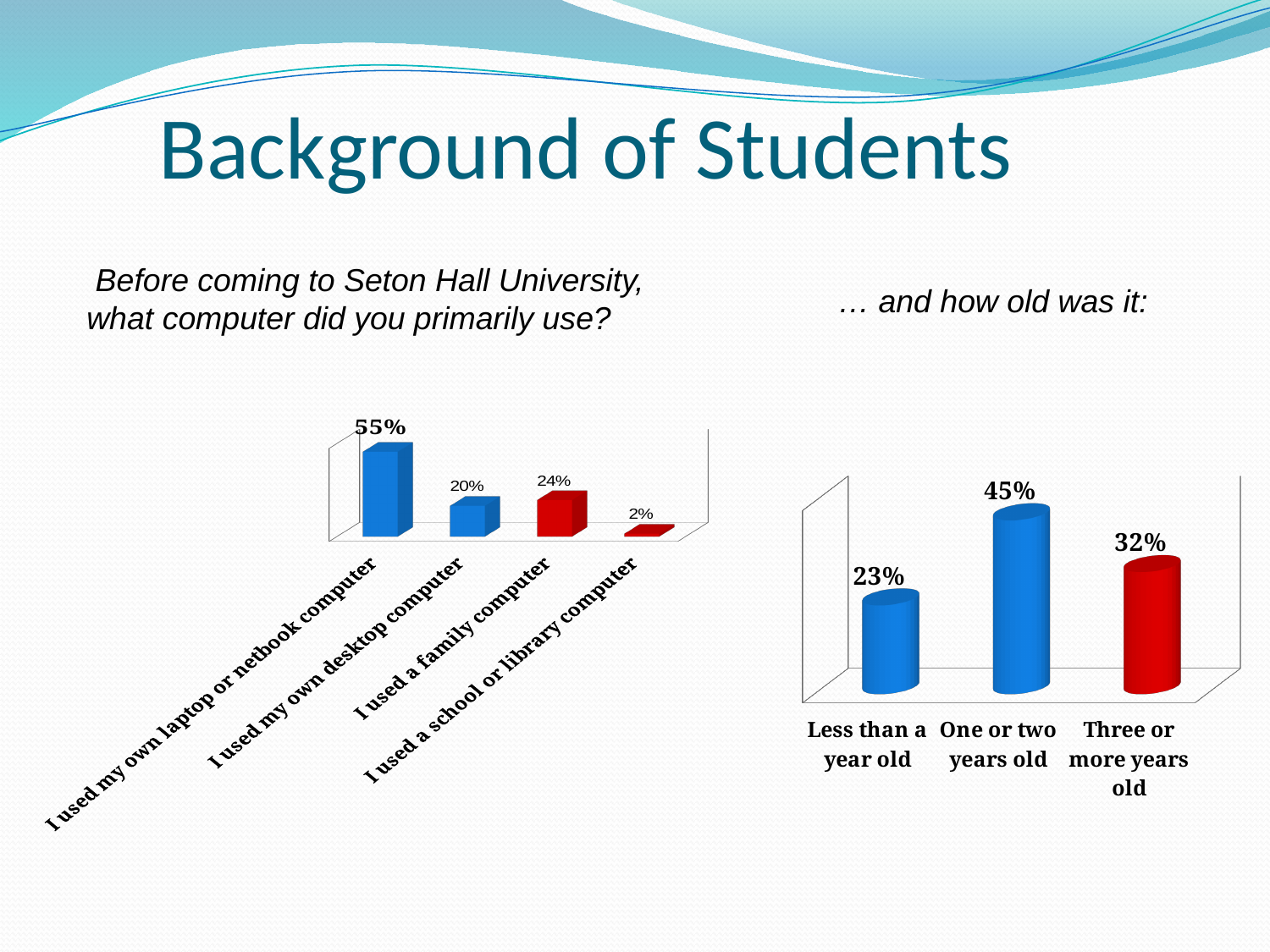
In the left chart (what computer did you primarily use), what percentage of students used a family computer? 24% In the left chart (what computer did you primarily use), which category has the lowest value? I used a school or library computer In the right chart (how old was it), what percentage of students said their computer was less than a year old? 23% In the right chart (how old was it), what is the difference between the values for one or two years old and three or more years old? 13% In the left chart (what computer did you primarily use), what percentage of students used their own laptop or netbook computer? 55% In the right chart (how old was it), which is larger: the value for three or more years old or less than a year old? Three or more years old What type of chart is the right chart (how old was it)? Bar chart In the right chart (how old was it), which category has the highest value? One or two years old In the left chart (what computer did you primarily use), which category has the highest value? I used my own laptop or netbook computer In the left chart (what computer did you primarily use), how many categories are shown? 4 In the left chart (what computer did you primarily use), what is the difference between the value for own laptop or netbook computer and own desktop computer? 35% In the right chart (how old was it), what percentage of students said their computer was one or two years old? 45%